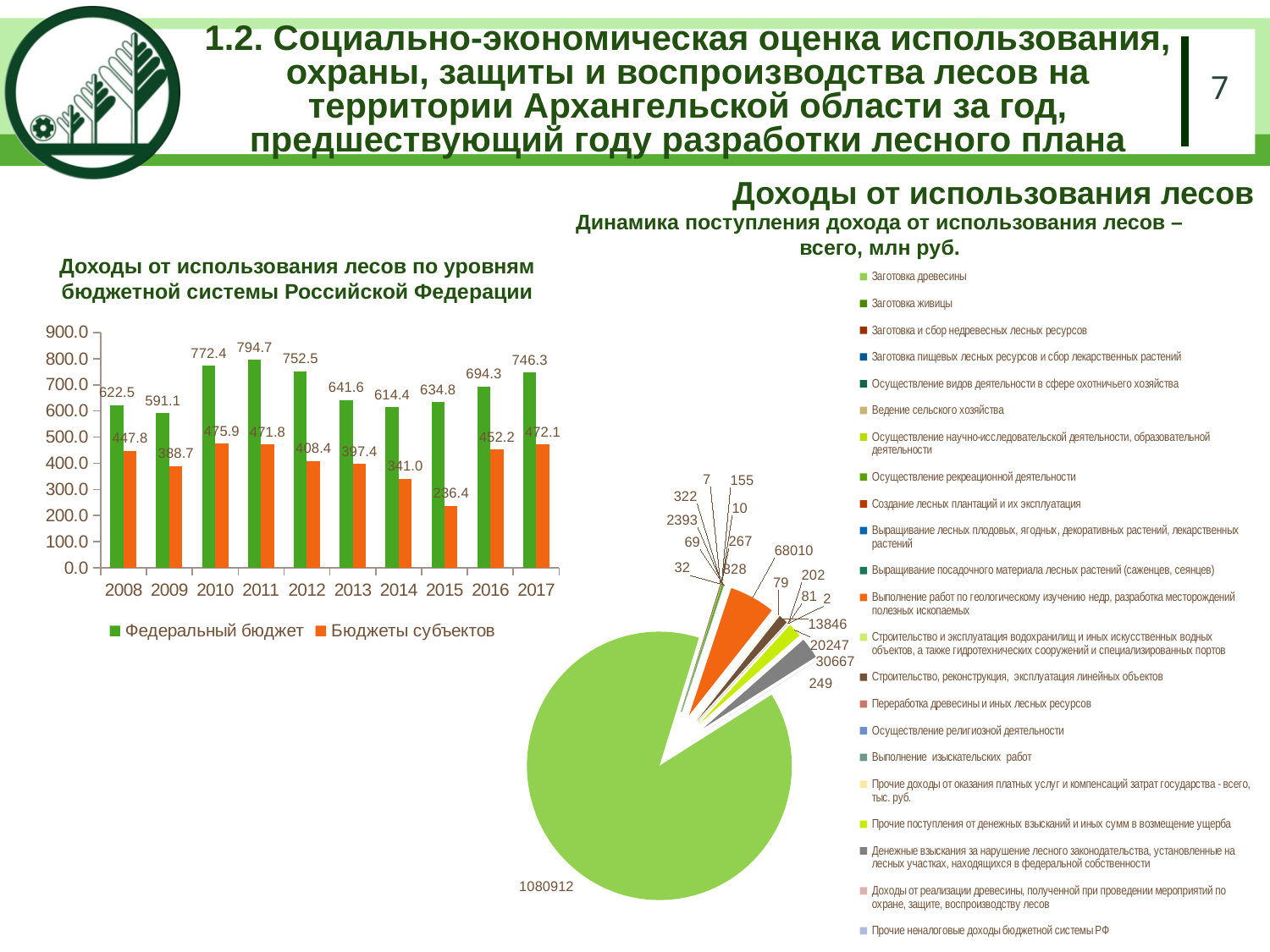
On the bar chart 'Доходы от использования лесов по уровням бюджетной системы Российской Федерации', what is the difference between Федеральный бюджет and Бюджеты субъектов in 2017? 274.2 On the bar chart 'Доходы от использования лесов по уровням бюджетной системы Российской Федерации', does the Федеральный бюджет value rise or fall from 2014 to 2017? rise On the bar chart 'Доходы от использования лесов по уровням бюджетной системы Российской Федерации', what is the value for Бюджеты субъектов in 2015? 236.4 What kind of chart is 'Динамика поступления дохода от использования лесов – всего, млн руб.'? pie chart On the bar chart 'Доходы от использования лесов по уровням бюджетной системы Российской Федерации', in which year is the Бюджеты субъектов value lowest? 2015 On the bar chart 'Доходы от использования лесов по уровням бюджетной системы Российской Федерации', what is the value for Федеральный бюджет in 2011? 794.7 On the bar chart 'Доходы от использования лесов по уровням бюджетной системы Российской Федерации', is the value for Бюджеты субъектов in 2014 greater or less than 400.0? less What kind of chart is 'Доходы от использования лесов по уровням бюджетной системы Российской Федерации'? bar chart On the bar chart 'Доходы от использования лесов по уровням бюджетной системы Российской Федерации', which is larger: Федеральный бюджет in 2010 or Федеральный бюджет in 2016? 2010 On the bar chart 'Доходы от использования лесов по уровням бюджетной системы Российской Федерации', in which year is the Федеральный бюджет value highest? 2011 On the bar chart 'Доходы от использования лесов по уровням бюджетной системы Российской Федерации', how many series does the legend list? 2 On the bar chart 'Доходы от использования лесов по уровням бюджетной системы Российской Федерации', how many years are shown on the x axis? 10